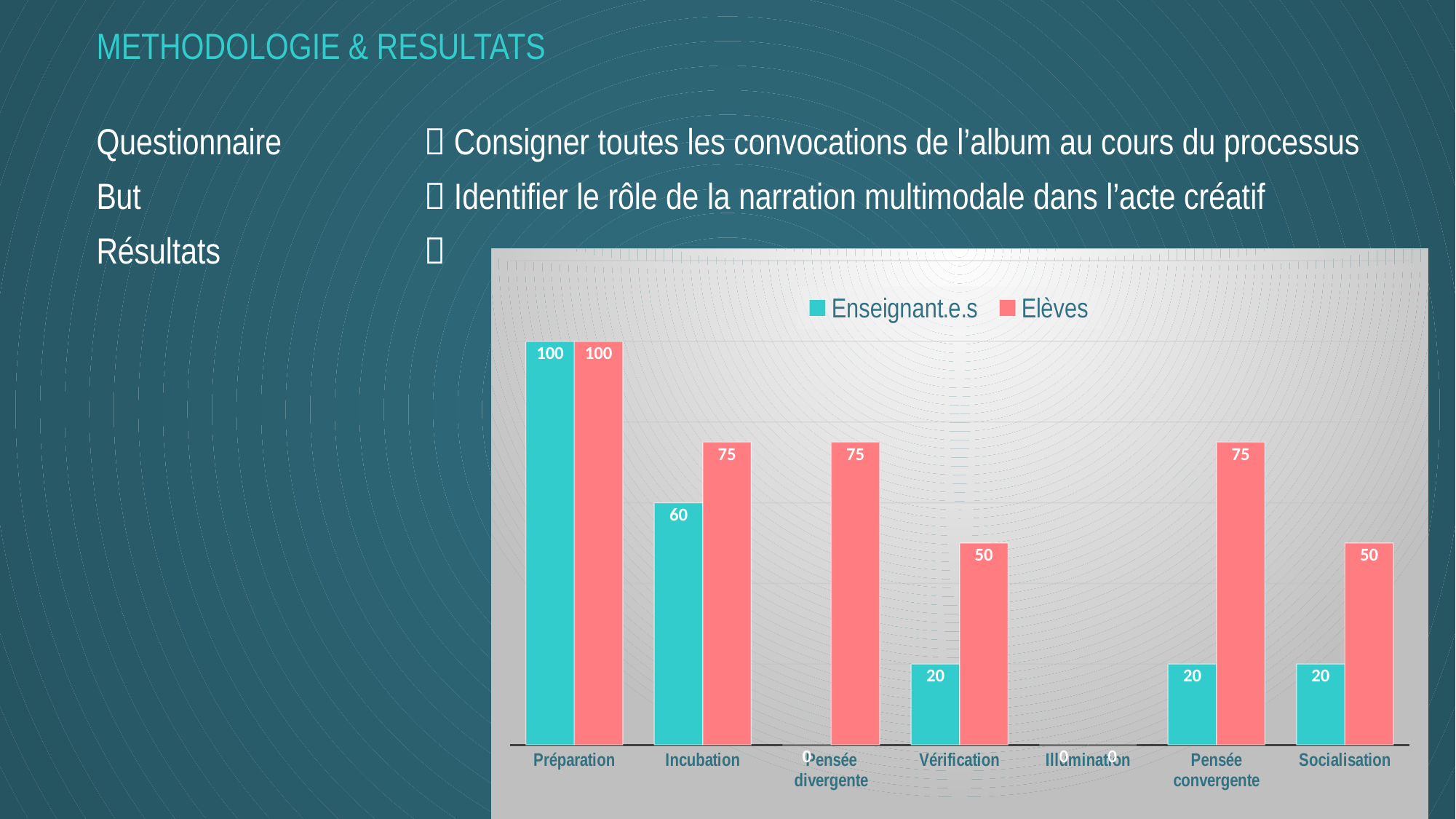
What is the value for Enseignant.e.s in the Incubation category? 60 How many series does the chart legend list? 2 In the Incubation category, which series has the larger value, Enseignant.e.s or Elèves? Elèves Which series is shown in red in the chart? Elèves What is the difference between the Elèves and Enseignant.e.s values in the Pensée convergente category? 55 Which category has the highest value for the Elèves series? Préparation What is the value for Enseignant.e.s in the Socialisation category? 20 What type of chart is shown on the slide? bar chart What is the value for Elèves in the Pensée convergente category? 75 Which category has the lowest value for the Elèves series? Illumination How many categories are shown on the x axis of the chart? 7 What is the value for Elèves in the Vérification category? 50